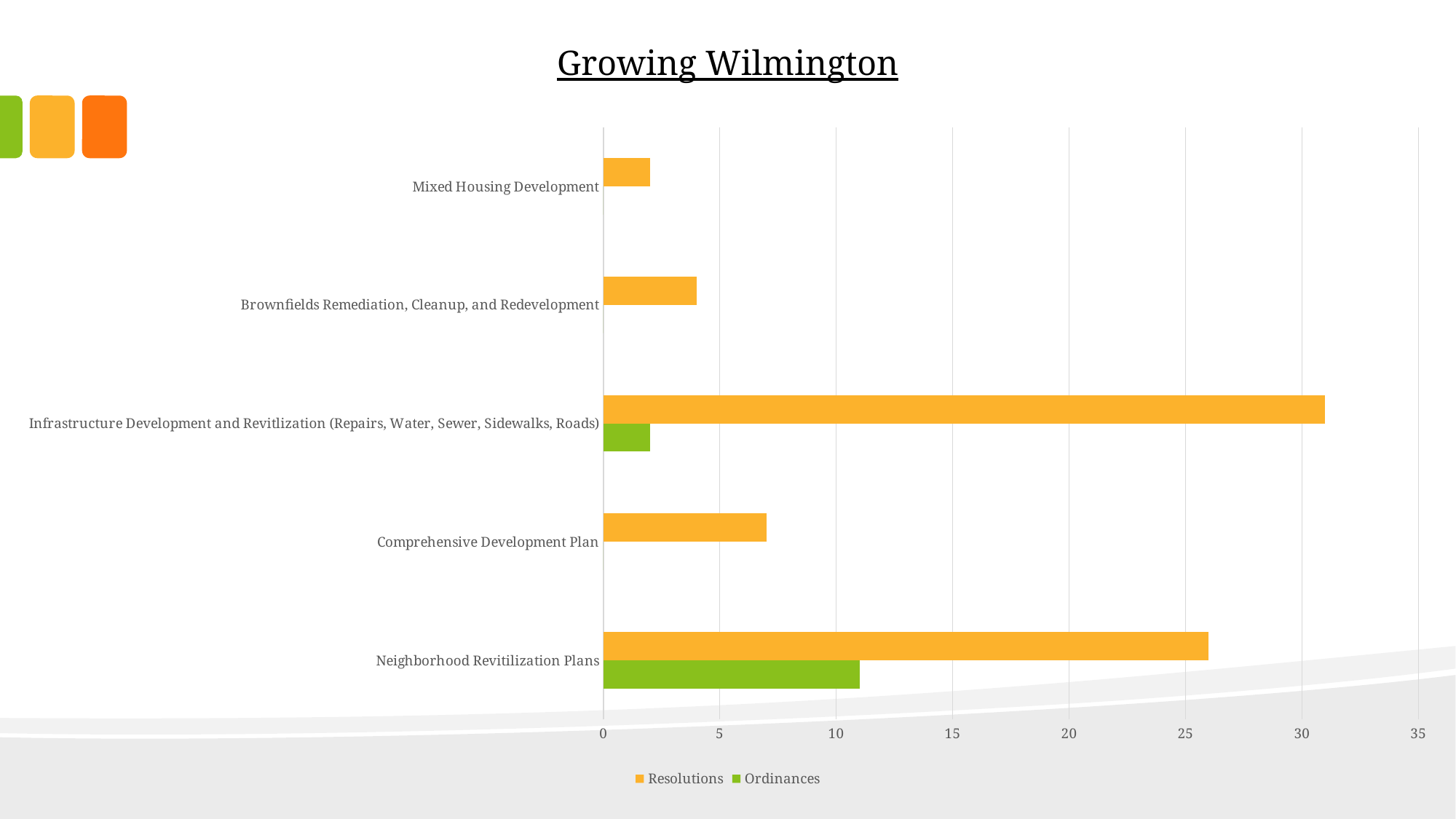
What kind of chart is shown on the slide? bar chart What is the title of the slide? Growing Wilmington Is the Resolutions value for Infrastructure Development and Revitlization greater or less than 30? greater Is the Resolutions value for Comprehensive Development Plan greater or less than 10? less How many series does the legend list? 2 Which category has the highest Resolutions value? Infrastructure Development and Revitlization (Repairs, Water, Sewer, Sidewalks, Roads) Which category has the lowest Resolutions value? Mixed Housing Development How many categories are shown on the chart? 5 Is the Resolutions value for Neighborhood Revitilization Plans greater or less than 25? greater Which category has the highest Ordinances value? Neighborhood Revitilization Plans Which is larger: the Resolutions value for Brownfields Remediation, Cleanup, and Redevelopment or for Comprehensive Development Plan? Comprehensive Development Plan